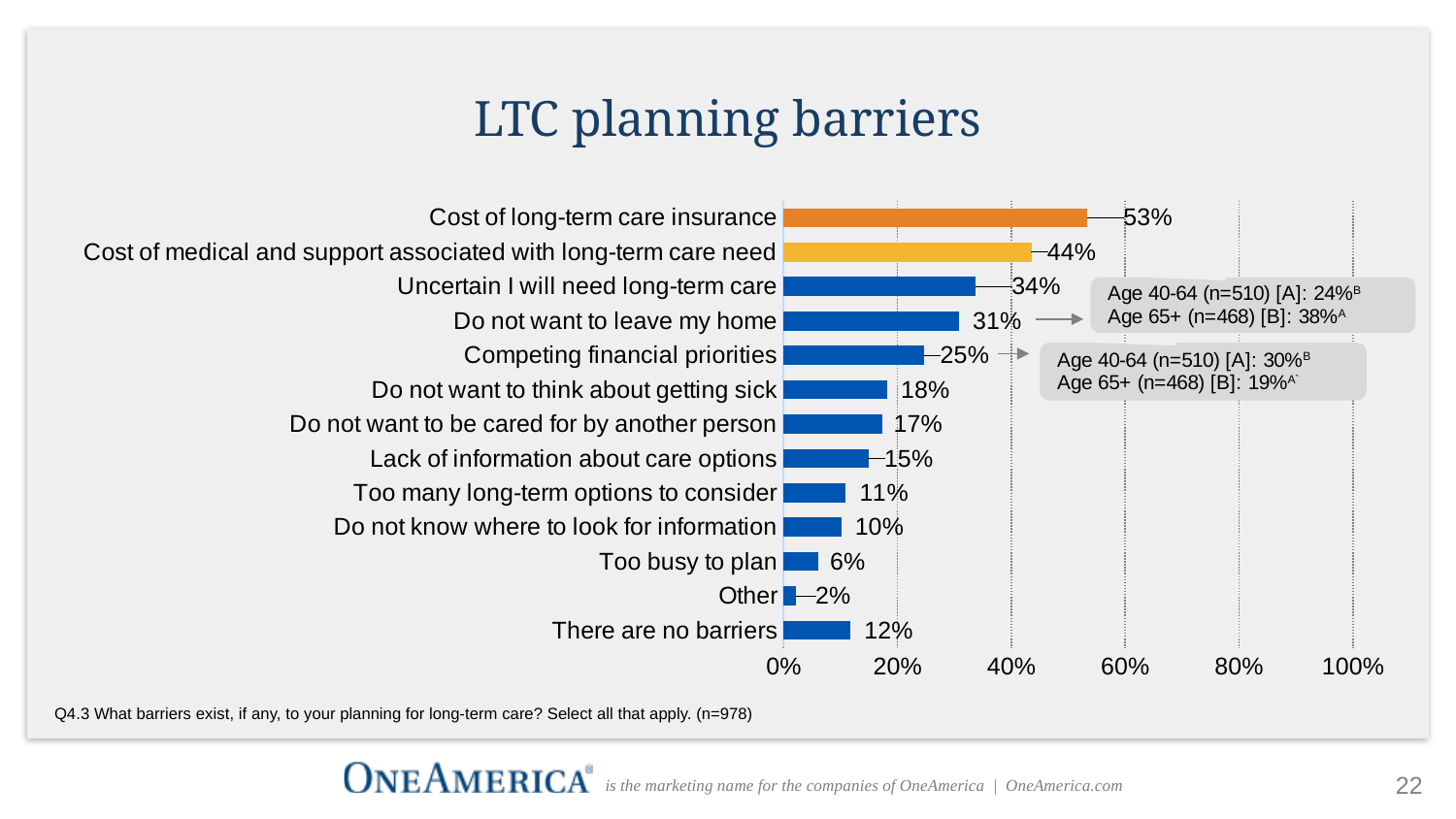
Which is larger: 'Competing financial priorities' or 'Do not want to think about getting sick'? Competing financial priorities Which barrier has the highest percentage? Cost of long-term care insurance According to the callout, what percentage of respondents aged 65+ cited 'Do not want to leave my home' as a barrier? 38% What is the value for 'There are no barriers'? 12% What is the value for 'Do not want to leave my home'? 31% Which category has the lowest percentage? Other What is the difference between 'Cost of long-term care insurance' and 'Cost of medical and support associated with long-term care need'? 9% What type of chart is shown on the slide? Bar chart What percentage of respondents cited cost of long-term care insurance as a barrier? 53% What is the title of the chart? LTC planning barriers How many categories are shown in the chart? 13 Is the value for 'Uncertain I will need long-term care' greater or less than 40%? less